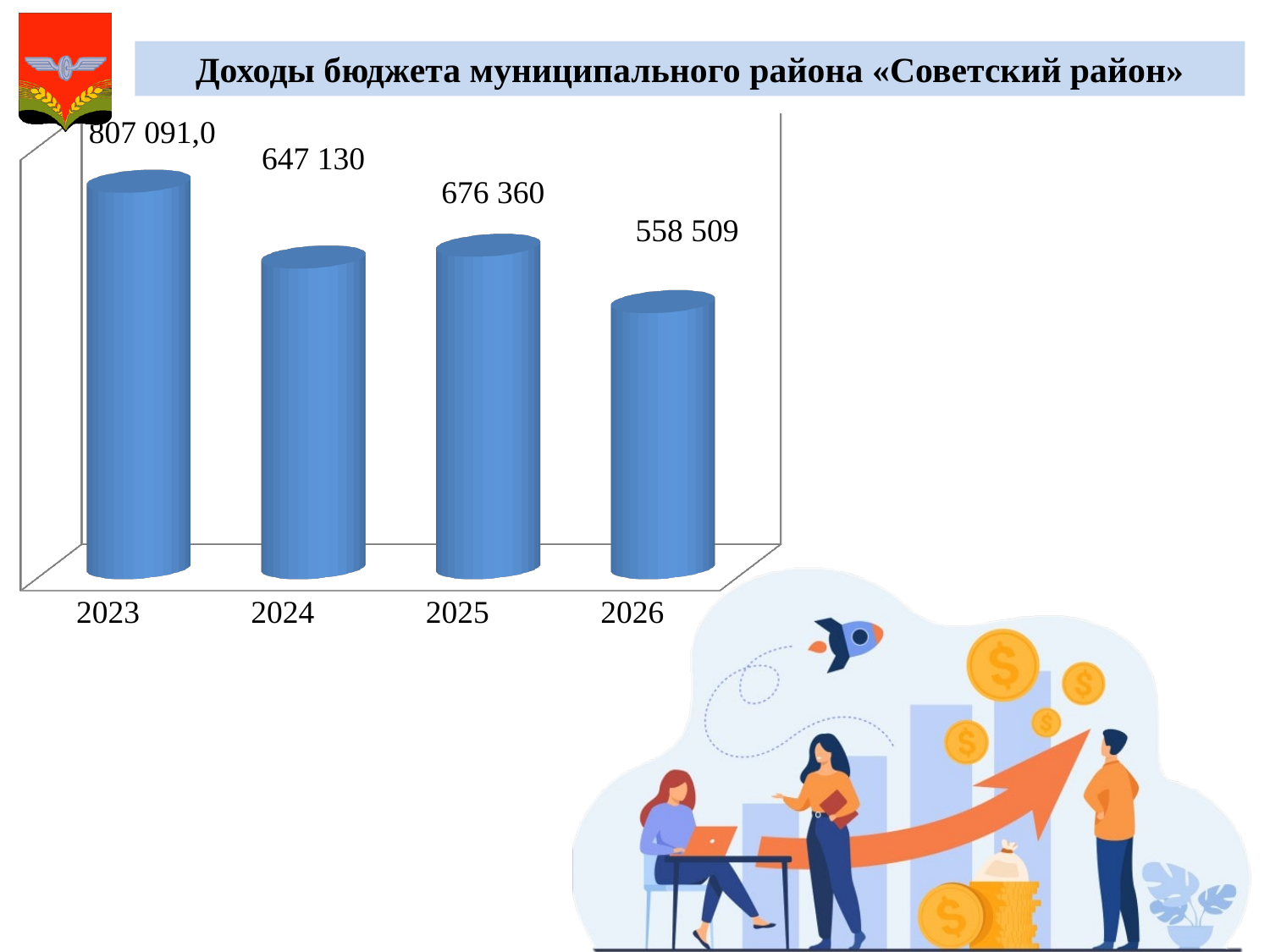
How many years are shown on the chart? 4 What is the title of the chart? Доходы бюджета муниципального района «Советский район» Which year has the lowest value? 2026 What is the difference between the values for 2025 and 2024? 29 230 What is the value shown for 2025? 676 360 What is the difference between the values for 2025 and 2026? 117 851 What kind of chart is shown on the slide? Bar chart What is the value shown for 2023? 807 091,0 Which year has the highest value? 2023 What is the value shown for 2026? 558 509 Which is larger, the value for 2024 or the value for 2025? 2025 What is the value shown for 2024? 647 130